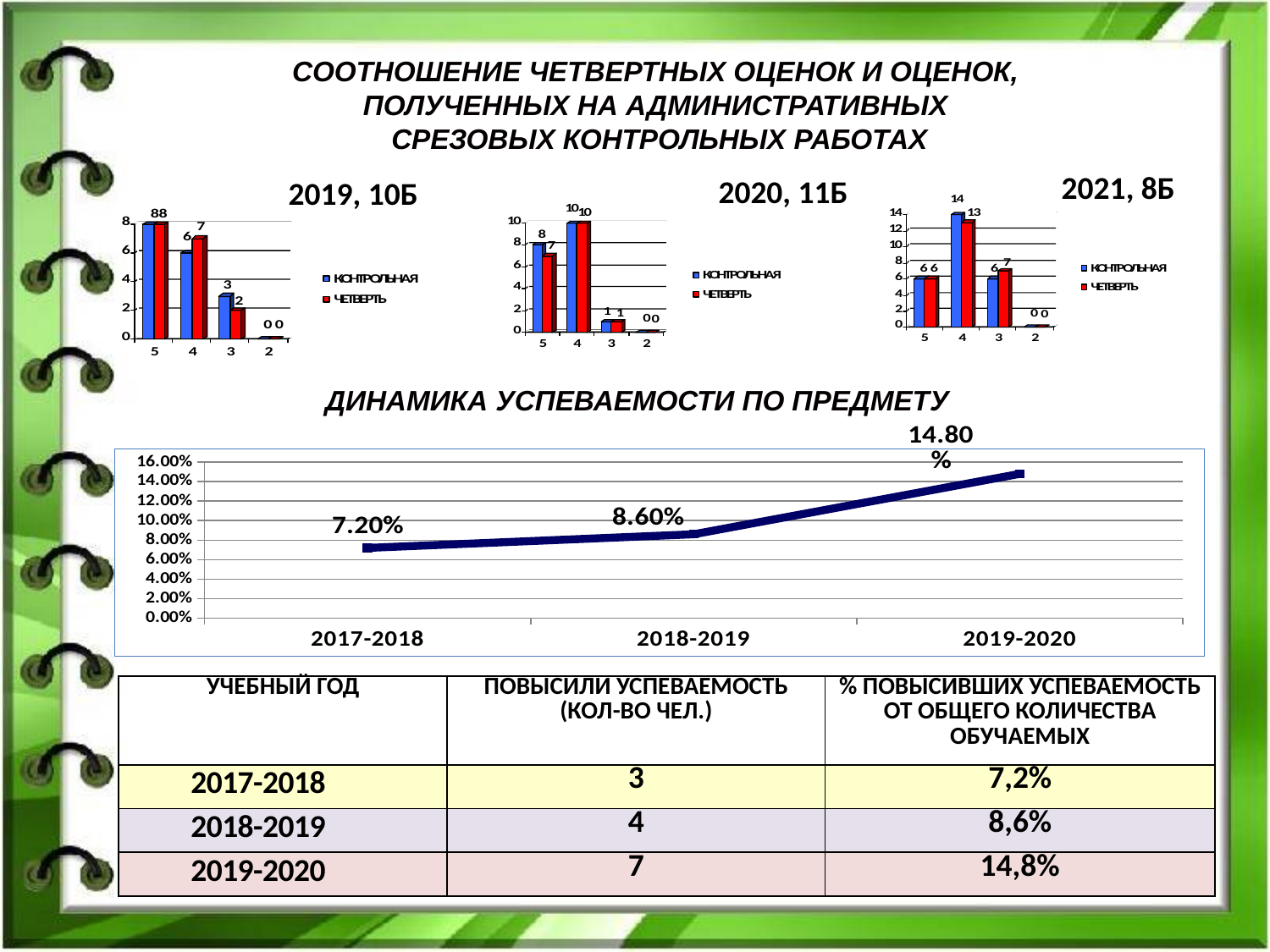
In the bar chart labelled 2021, 8Б, what is the КОНТРОЛЬНАЯ value for category 4? 14 In the bar chart labelled 2019, 10Б, which category has the highest values? 5 In the line chart titled ДИНАМИКА УСПЕВАЕМОСТИ ПО ПРЕДМЕТУ, what is the value for 2019-2020? 14.80% How many series does the legend of the bar chart labelled 2021, 8Б list? 2 In the bar chart labelled 2020, 11Б, which category has the highest values? 4 In the bar chart labelled 2020, 11Б, what is the ЧЕТВЕРТЬ value for category 5? 7 In the line chart titled ДИНАМИКА УСПЕВАЕМОСТИ ПО ПРЕДМЕТУ, what is the value for 2017-2018? 7.20% In the line chart titled ДИНАМИКА УСПЕВАЕМОСТИ ПО ПРЕДМЕТУ, do the values rise or fall from 2017-2018 to 2019-2020? rise In the line chart titled ДИНАМИКА УСПЕВАЕМОСТИ ПО ПРЕДМЕТУ, how many data points are plotted? 3 In the bar chart labelled 2021, 8Б, which is larger for category 3: КОНТРОЛЬНАЯ or ЧЕТВЕРТЬ? ЧЕТВЕРТЬ In the line chart titled ДИНАМИКА УСПЕВАЕМОСТИ ПО ПРЕДМЕТУ, what is the difference between the 2019-2020 value and the 2018-2019 value? 6.20% In the bar chart labelled 2019, 10Б, what is the КОНТРОЛЬНАЯ value for category 4? 6